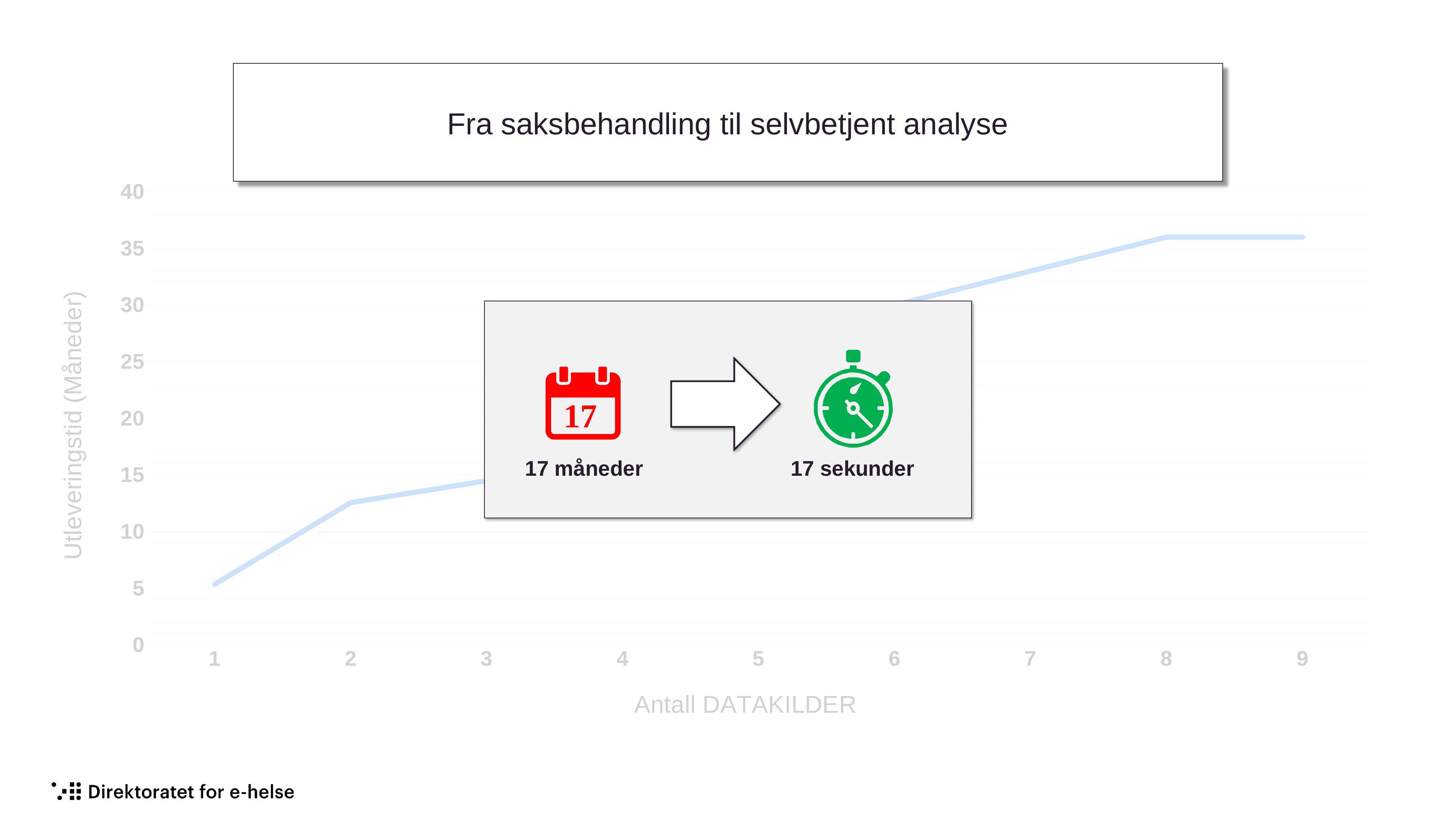
What is the label of the x axis? Antall DATAKILDER Is the delivery time for 9 data sources greater or less than 40 months? less What is the title shown above the chart? Fra saksbehandling til selvbetjent analyse Which has the higher delivery time: 2 data sources or 8 data sources? 8 data sources Is the delivery time for 2 data sources greater or less than 10 months? greater Which number of data sources has the lowest delivery time? 1 Does the delivery time (Utleveringstid) rise or fall as the number of data sources increases? rise How many x-axis categories (data sources) are shown on the chart? 9 Is the delivery time for 7 data sources greater or less than 30 months? greater What kind of chart is shown on the slide? line chart